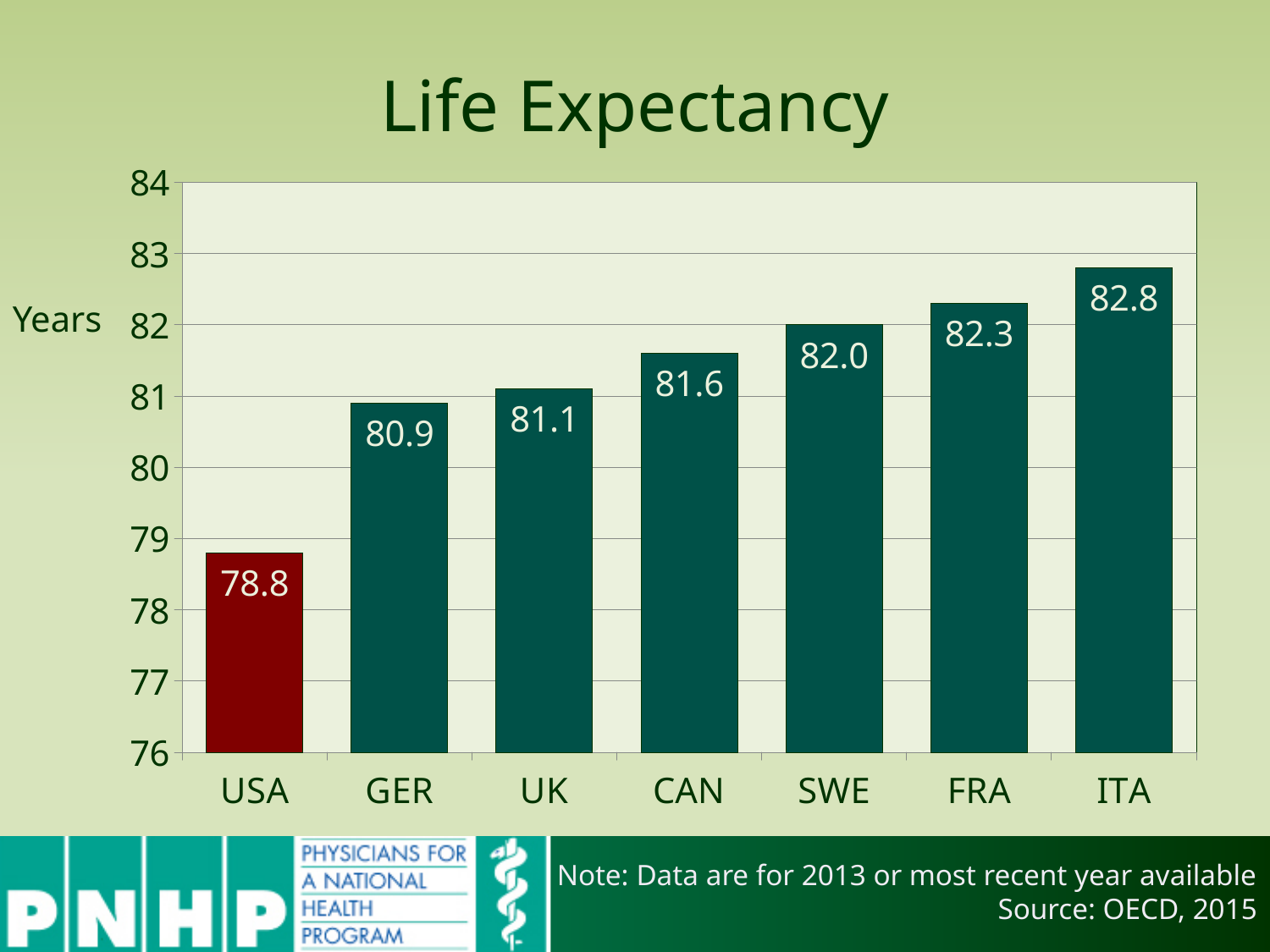
What is the life expectancy value shown for the USA? 78.8 How many countries are shown in the chart? 7 What kind of chart is shown on the slide? bar chart Which has a higher life expectancy, UK or CAN? CAN What is the difference in life expectancy between ITA and the USA? 4.0 Which country has the lowest life expectancy in the chart? USA Is the value for GER greater or less than 81? less Which bar is coloured differently from the others? USA What is the life expectancy value shown for FRA? 82.3 What is the life expectancy value shown for CAN? 81.6 What is the difference in life expectancy between SWE and GER? 1.1 Which country has the highest life expectancy in the chart? ITA